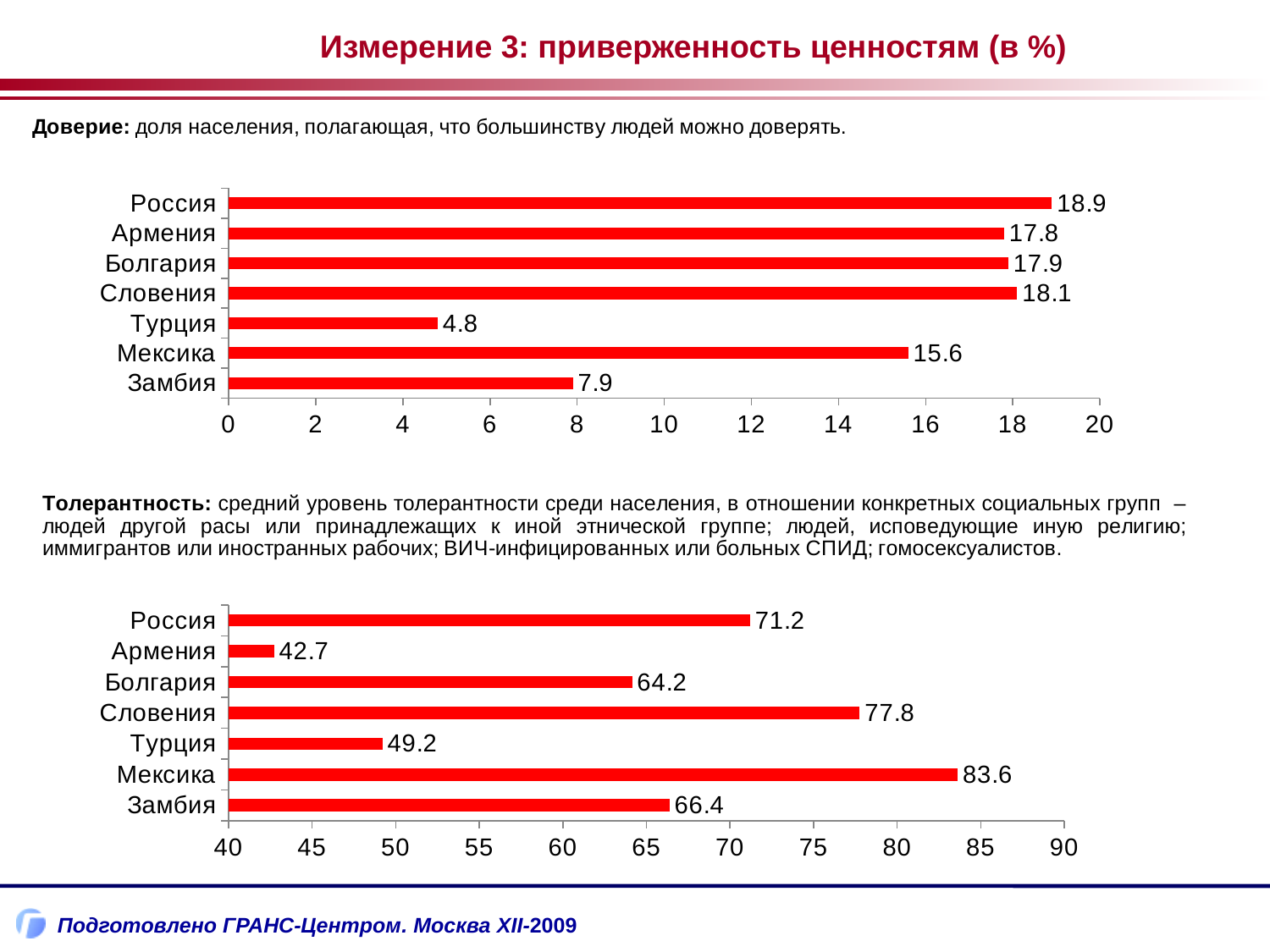
In the bottom chart (Толерантность), what is the value for Словения? 77.8 In the bottom chart (Толерантность), which country has the highest value? Мексика In the top chart (Доверие), which country has the lowest value? Турция In the bottom chart (Толерантность), what is the difference between the values for Мексика and Армения? 40.9 In the top chart (Доверие), how many countries are shown? 7 In the top chart (Доверие), what is the value for Россия? 18.9 In the top chart (Доверие), what is the difference between the values for Россия and Турция? 14.1 In the top chart (Доверие), what is the value for Мексика? 15.6 What type of chart is the bottom chart (Толерантность)? Bar chart In the bottom chart (Толерантность), which country has the lowest value? Армения In the bottom chart (Толерантность), which is larger, the value for Болгария or the value for Замбия? Замбия In the top chart (Доверие), which country has the highest value? Россия